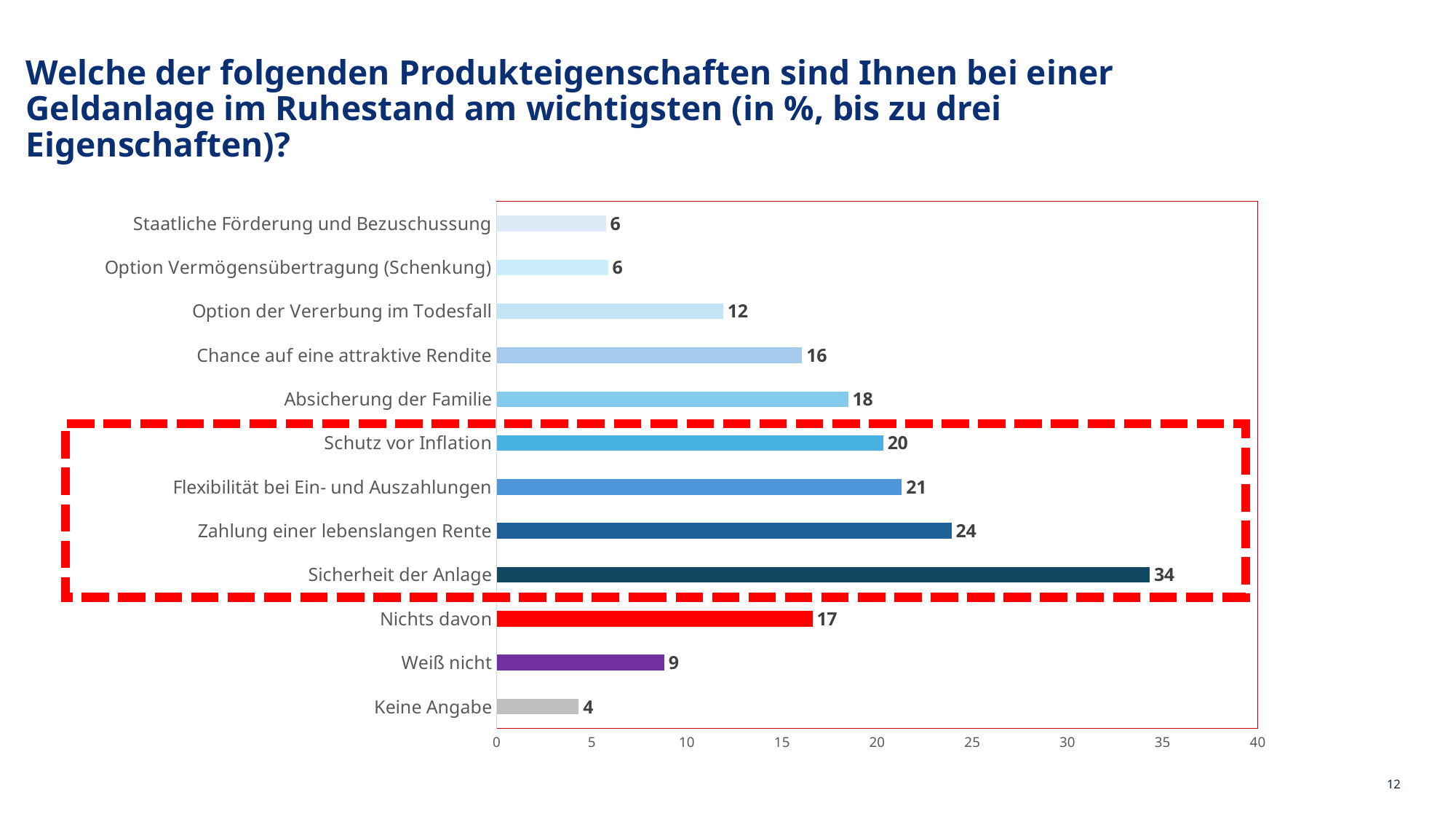
What is the value for Zahlung einer lebenslangen Rente? 24 What colour is the bar for Nichts davon? red What kind of chart is shown on the slide? bar chart What is the difference between the values for Sicherheit der Anlage and Zahlung einer lebenslangen Rente? 10 What is the value for Sicherheit der Anlage? 34 Is the value for Flexibilität bei Ein- und Auszahlungen greater or less than 20? greater Which is larger, the value for Schutz vor Inflation or the value for Absicherung der Familie? Schutz vor Inflation How many categories are shown in the chart? 12 Which category has the lowest value? Keine Angabe What is the value for Nichts davon? 17 What is the value for Weiß nicht? 9 Which category has the highest value? Sicherheit der Anlage